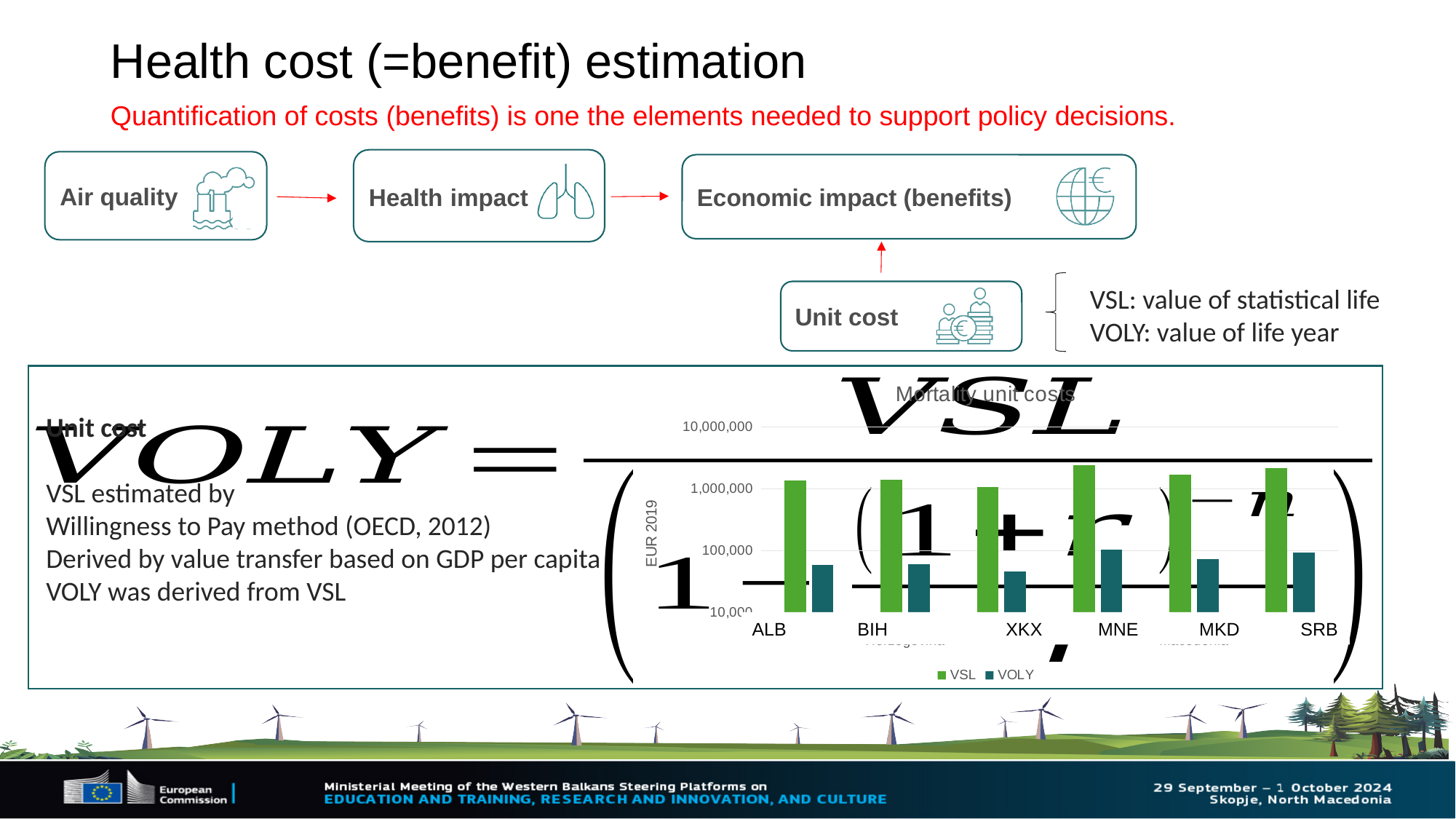
In the "Mortality unit costs" chart, which is larger: the VSL value for ALB or the VSL value for MNE? MNE What is the y-axis label of the "Mortality unit costs" chart? EUR 2019 What kind of chart is the "Mortality unit costs" chart? bar chart What is the title of the chart on the slide? Mortality unit costs In the "Mortality unit costs" chart, which country has the lowest VOLY value? XKX In the "Mortality unit costs" chart, is the VSL value for SRB greater or less than 1,000,000? greater How many countries are shown on the x axis of the "Mortality unit costs" chart? 6 In the "Mortality unit costs" chart, which country has the lowest VSL value? XKX In the "Mortality unit costs" chart, is the VOLY value for BIH greater or less than 100,000? less In the "Mortality unit costs" chart, which is larger: the VOLY value for XKX or the VOLY value for MKD? MKD How many series does the legend of the "Mortality unit costs" chart list? 2 In the "Mortality unit costs" chart, is the VSL value for ALB greater or less than 1,000,000? greater